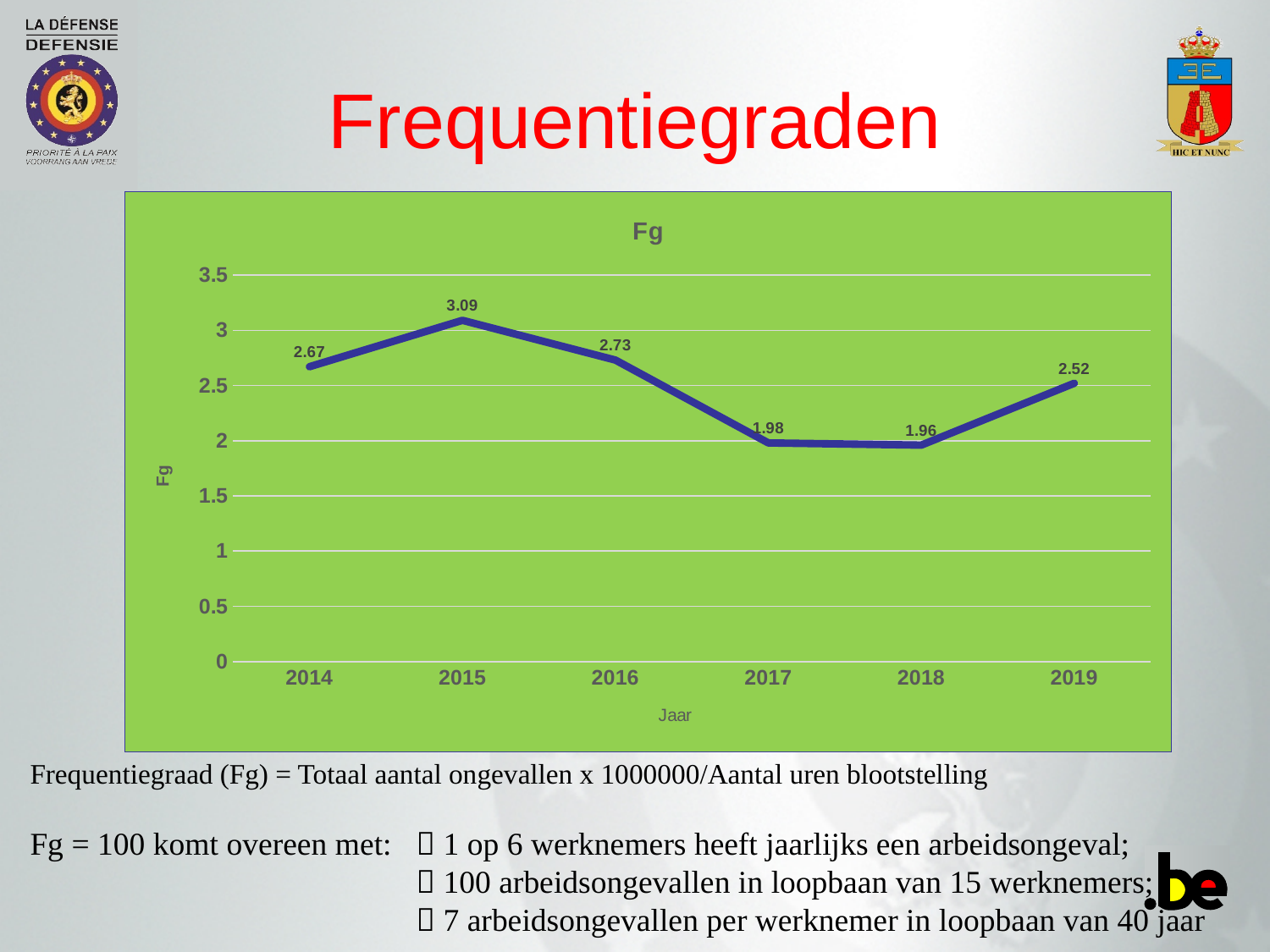
Which year has the highest Fg value? 2015 Does the Fg value rise or fall from 2016 to 2017? fall How many years are plotted on the chart? 6 What is the Fg value for 2019? 2.52 What kind of chart is shown on the slide? line chart What is the Fg value for 2018? 1.96 Which year has a higher Fg value, 2016 or 2019? 2016 Which year has the lowest Fg value? 2018 Is the Fg value for 2017 greater or less than 2.5? less What is the Fg value for 2015? 3.09 What is the label of the x axis of the chart? Jaar What is the difference between the Fg values for 2015 and 2014? 0.42